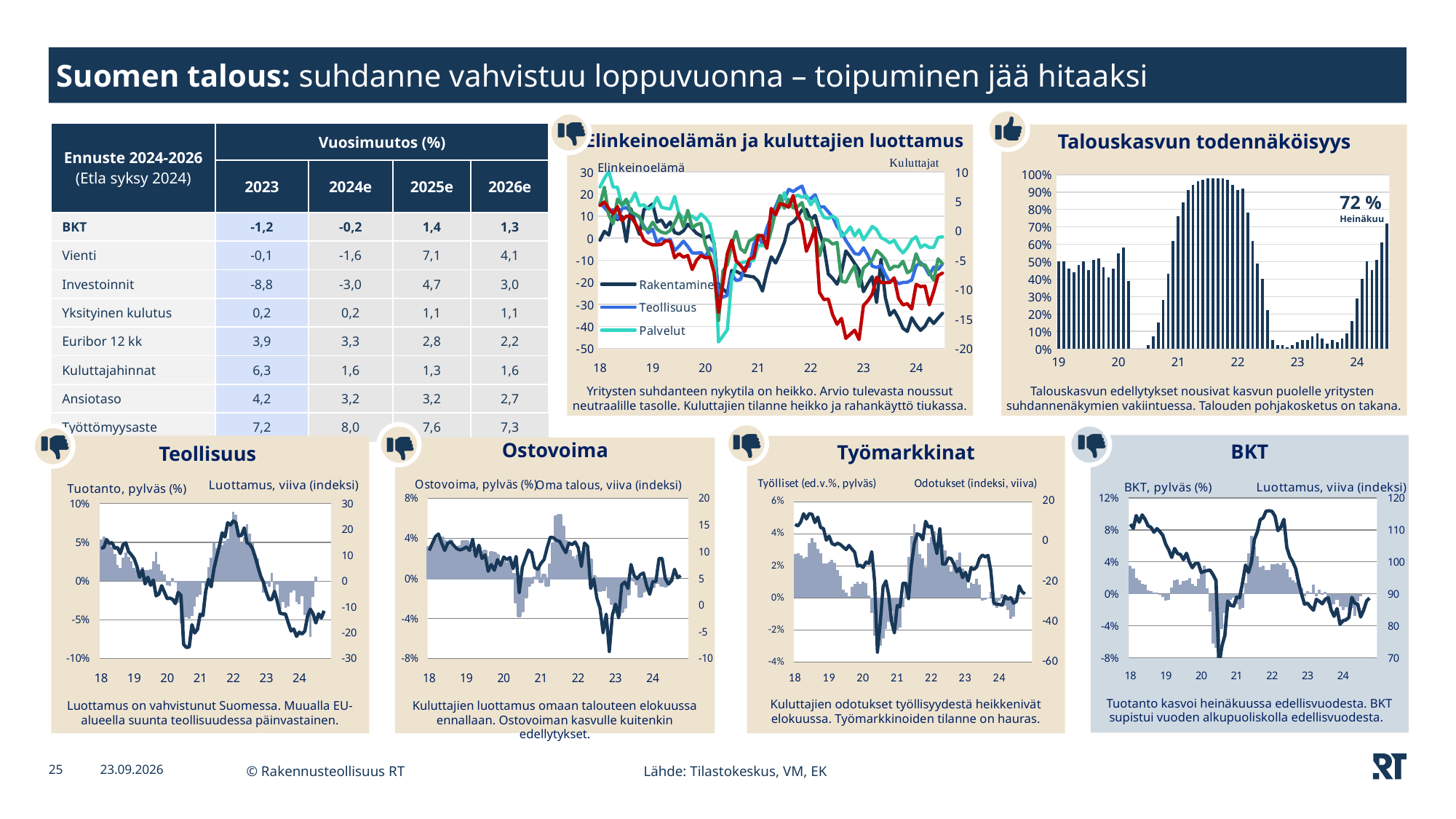
What kind of chart is "Talouskasvun todennäköisyys"? bar chart How many year labels are shown on the x axis of the "Teollisuus" chart? 7 In the "Talouskasvun todennäköisyys" chart, is the highest bar in 2021 greater or less than 90%? greater In the "Talouskasvun todennäköisyys" chart, do the bars rise or fall from 2023 to 2024? rise In the "Talouskasvun todennäköisyys" chart, is the labelled Heinäkuu value greater or less than 50%? greater What kind of chart is "Elinkeinoelämän ja kuluttajien luottamus"? line chart In the "Talouskasvun todennäköisyys" chart, is the first bar in 2019 greater or less than 40%? greater How many series does the legend of the "Elinkeinoelämän ja kuluttajien luottamus" chart list? 3 In the "Talouskasvun todennäköisyys" chart, what value is printed as the data label for Heinäkuu? 72 % In the "Talouskasvun todennäköisyys" chart, do the bars rise or fall from the end of 2021 into 2022? fall In the "BKT" chart, what is the highest value shown on the right axis? 120 In the "Elinkeinoelämän ja kuluttajien luottamus" chart, what is the highest value shown on the left axis? 30